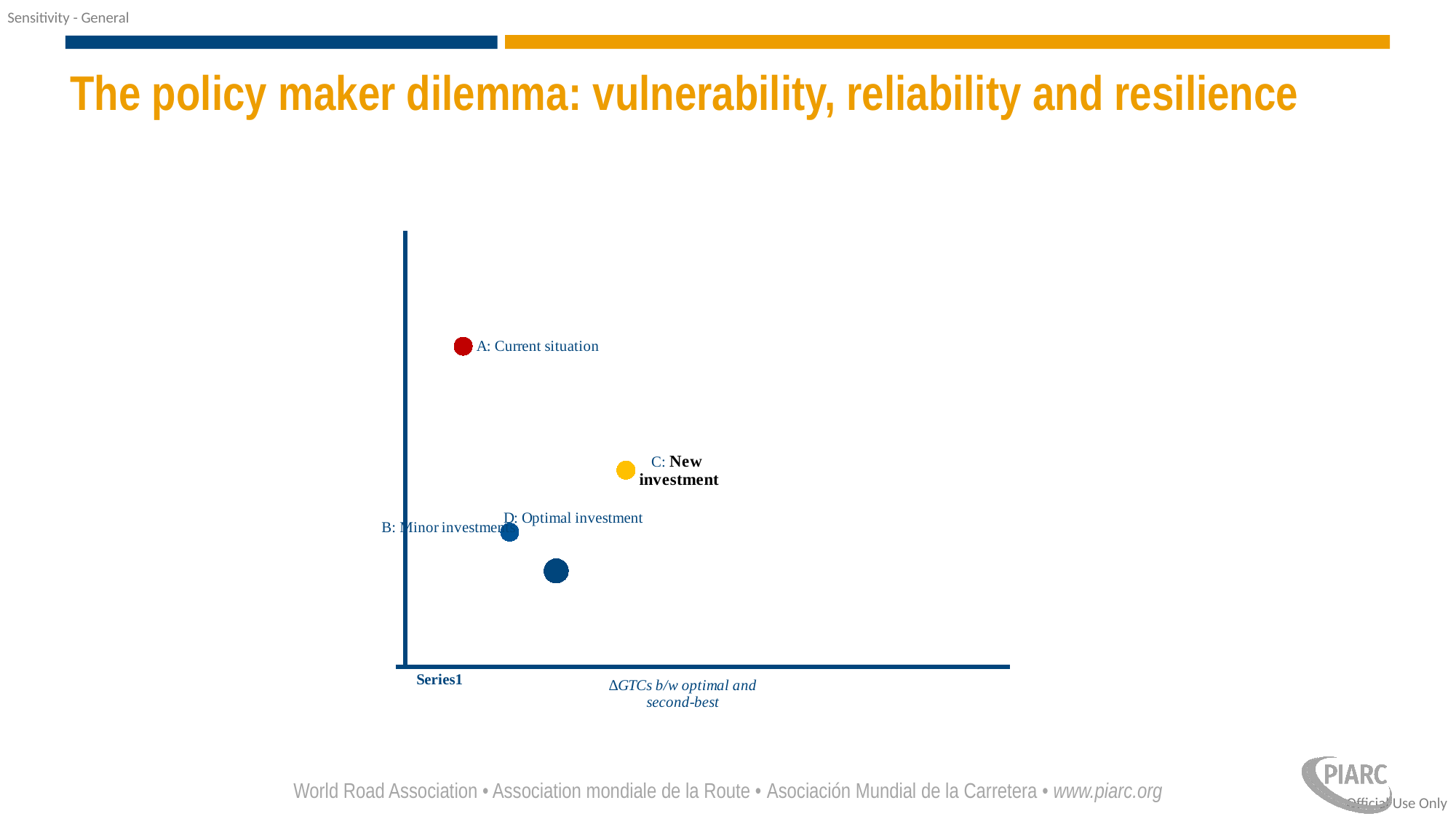
Which point is further left on the x axis, A: Current situation or C: New investment? A: Current situation What is the label on the x axis of the chart? ΔGTCs b/w optimal and second-best How many data points are plotted on the chart? 4 Which plotted point is furthest to the right along the x axis? C: New investment What colour is the marker for A: Current situation? Red What kind of chart is shown on the slide? Scatter chart Which point is positioned higher on the chart, A: Current situation or C: New investment? A: Current situation Which plotted point sits highest on the vertical axis? A: Current situation